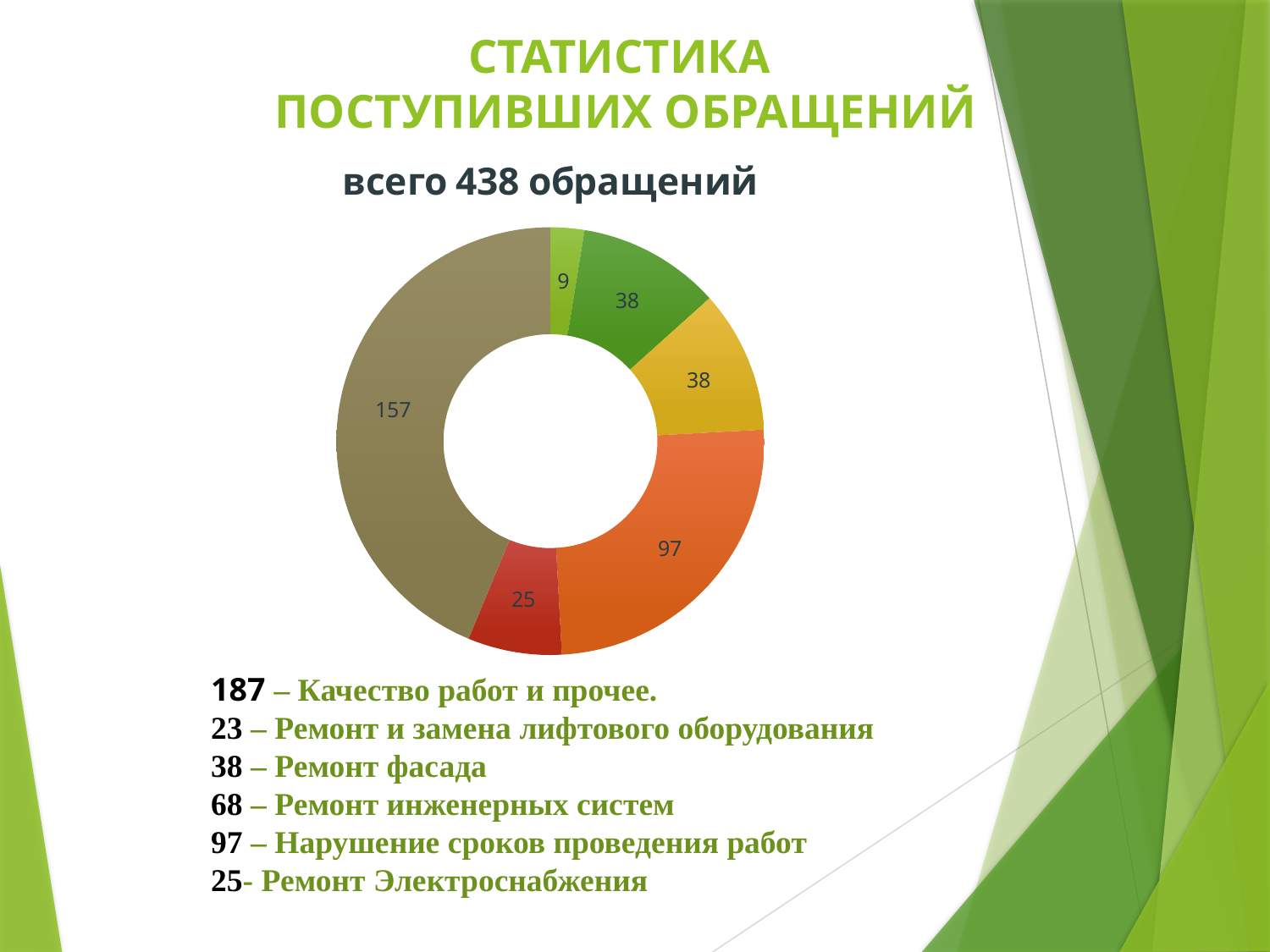
What is the smallest value labelled on the doughnut chart? 9 What value is labelled on the orange slice of the doughnut chart? 97 What value is labelled on the red slice of the doughnut chart? 25 What kind of chart is shown on the slide? Doughnut (pie) chart What is the difference between the largest slice value (157) and the orange slice value (97)? 60 What is the difference between the orange slice (97) and the red slice (25)? 72 What value is labelled on the light green slice of the doughnut chart? 9 What value is labelled on the yellow slice of the doughnut chart? 38 What total number of appeals is stated in the subtitle above the chart? 438 What is the largest value labelled on the doughnut chart? 157 Which is larger: the orange slice (97) or the yellow slice (38)? The orange slice (97) How many slices does the doughnut chart have? 6